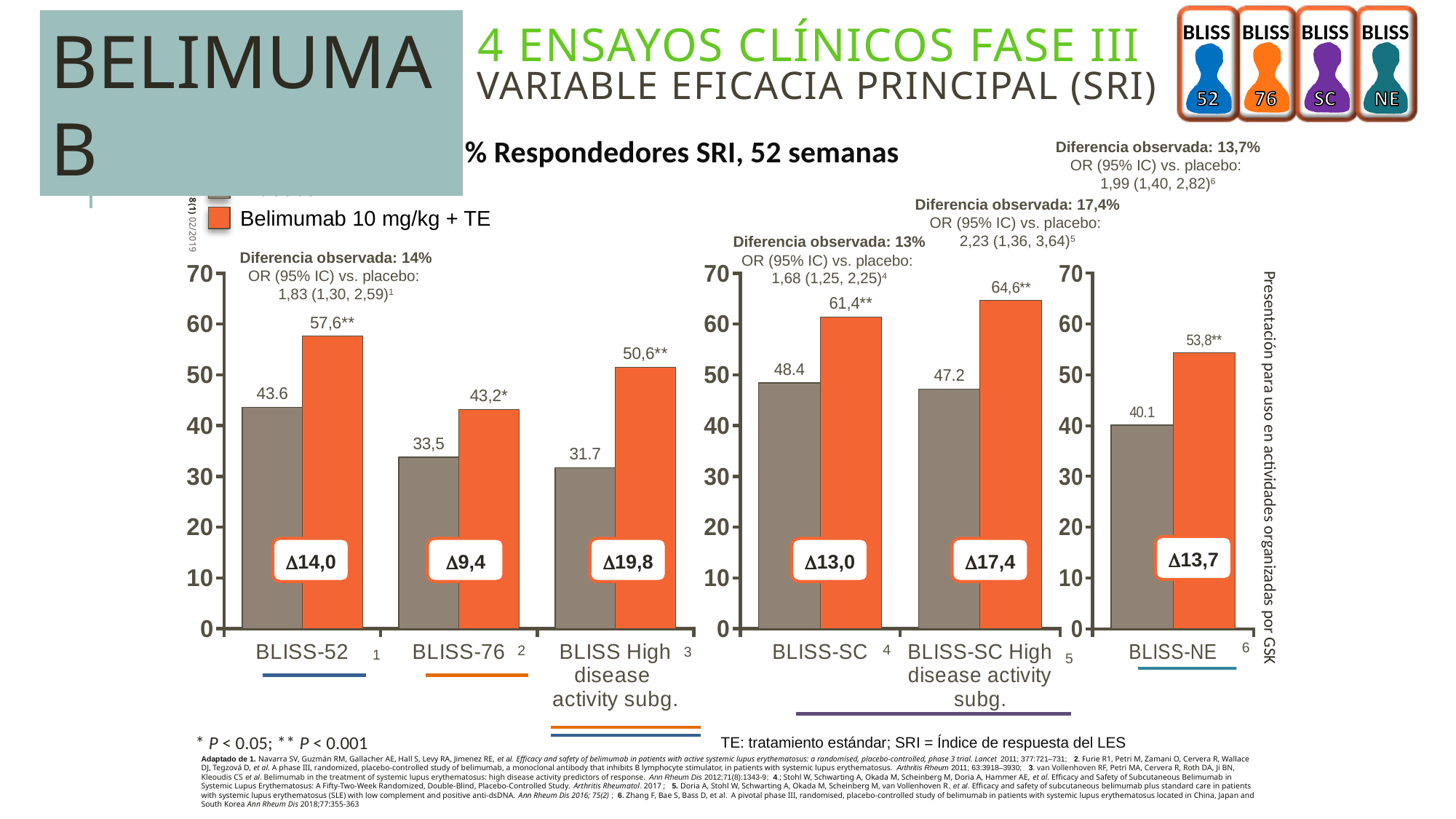
In the middle chart, what is the value of the Belimumab 10 mg/kg + TE bar for BLISS-SC High disease activity subg.? 64,6 In the left chart, which category has the highest Belimumab 10 mg/kg + TE value? BLISS-52 In the left chart, what is the value of the grey bar for BLISS-76? 33,5 In the left chart, which category has the lowest grey bar value? BLISS High disease activity subg. In the left chart, what is the difference (Δ) shown between the Belimumab and grey bars for BLISS High disease activity subg.? 19,8 In the middle chart, which is larger: the grey bar for BLISS-SC or the grey bar for BLISS-SC High disease activity subg.? BLISS-SC In the middle chart, what is the difference (Δ) shown for BLISS-SC? 13,0 What kind of chart is used on this slide? Bar chart In the right chart, is the Belimumab 10 mg/kg + TE value for BLISS-NE greater or less than 50? greater How many categories are shown on the x axis of the left chart? 3 In the right chart, what is the value of the grey bar for BLISS-NE? 40.1 In the left chart, what is the value of the Belimumab 10 mg/kg + TE bar for BLISS-52? 57,6